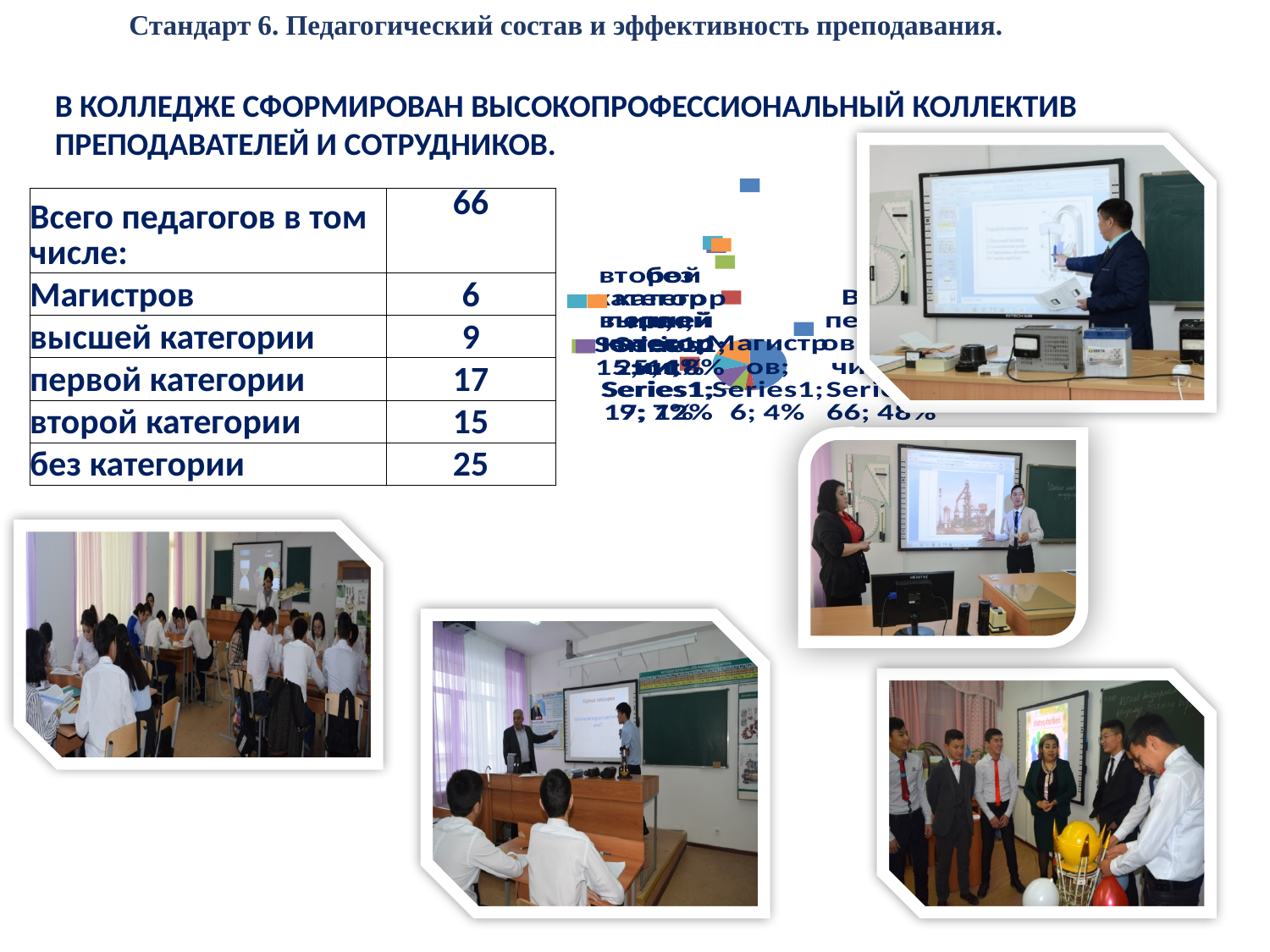
In the pie chart, what percentage label is shown next to the value 6? 4% What kind of chart is shown on the slide next to the table? pie chart In the pie chart, what percentage label is shown next to the value 66? 48%